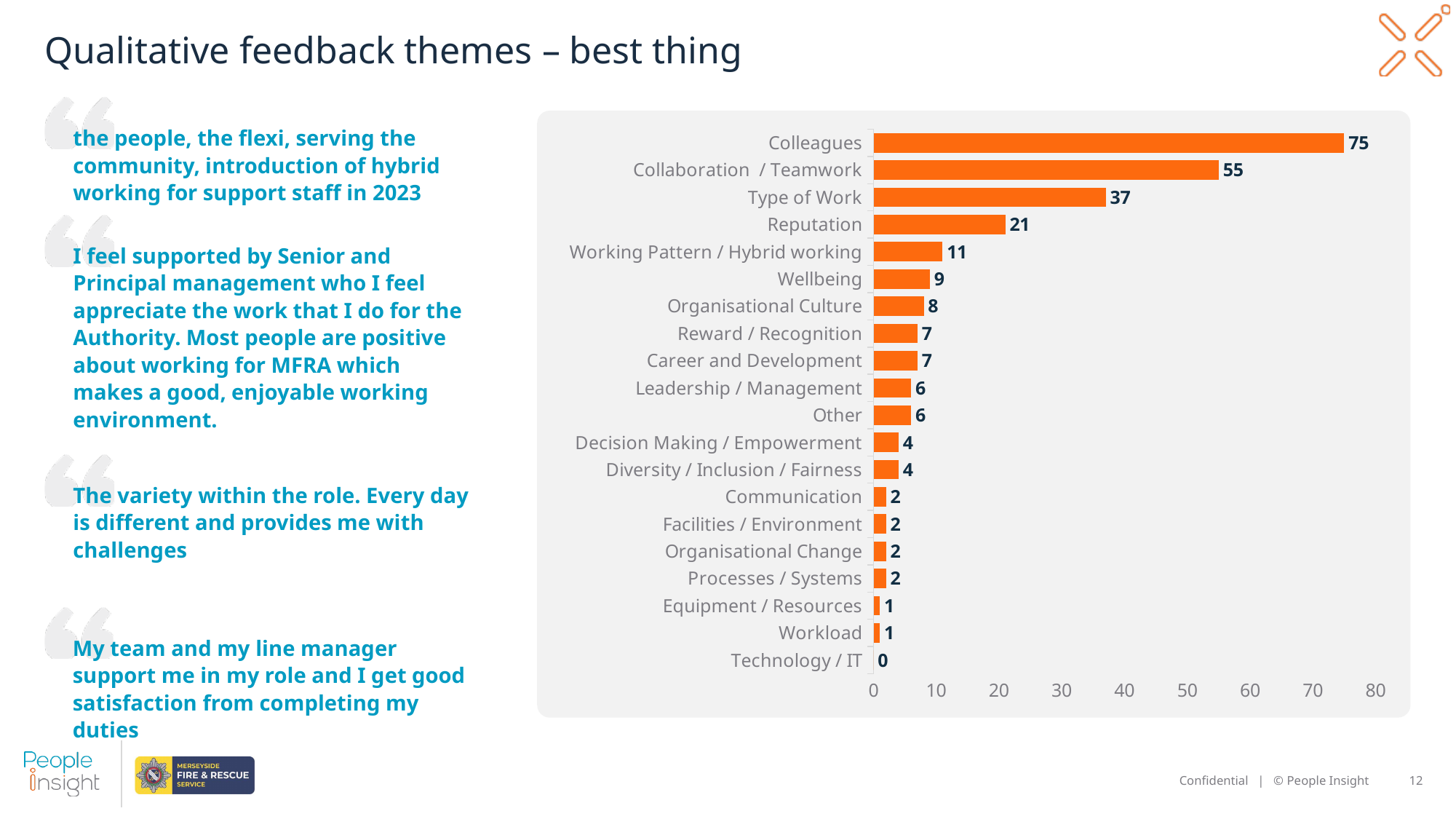
What colour are the bars in the chart? Orange What is the value for Reputation? 21 Which category has the highest value? Colleagues Is the value for Collaboration / Teamwork greater or less than 50? greater What is the value for Wellbeing? 9 What is the value for Working Pattern / Hybrid working? 11 Which category has the lowest value? Technology / IT What is the difference between the values for Colleagues and Collaboration / Teamwork? 20 Which is larger, the value for Type of Work or the value for Reputation? Type of Work How many categories are shown in the chart? 20 What is the value for Colleagues? 75 What kind of chart is shown on the slide? Bar chart